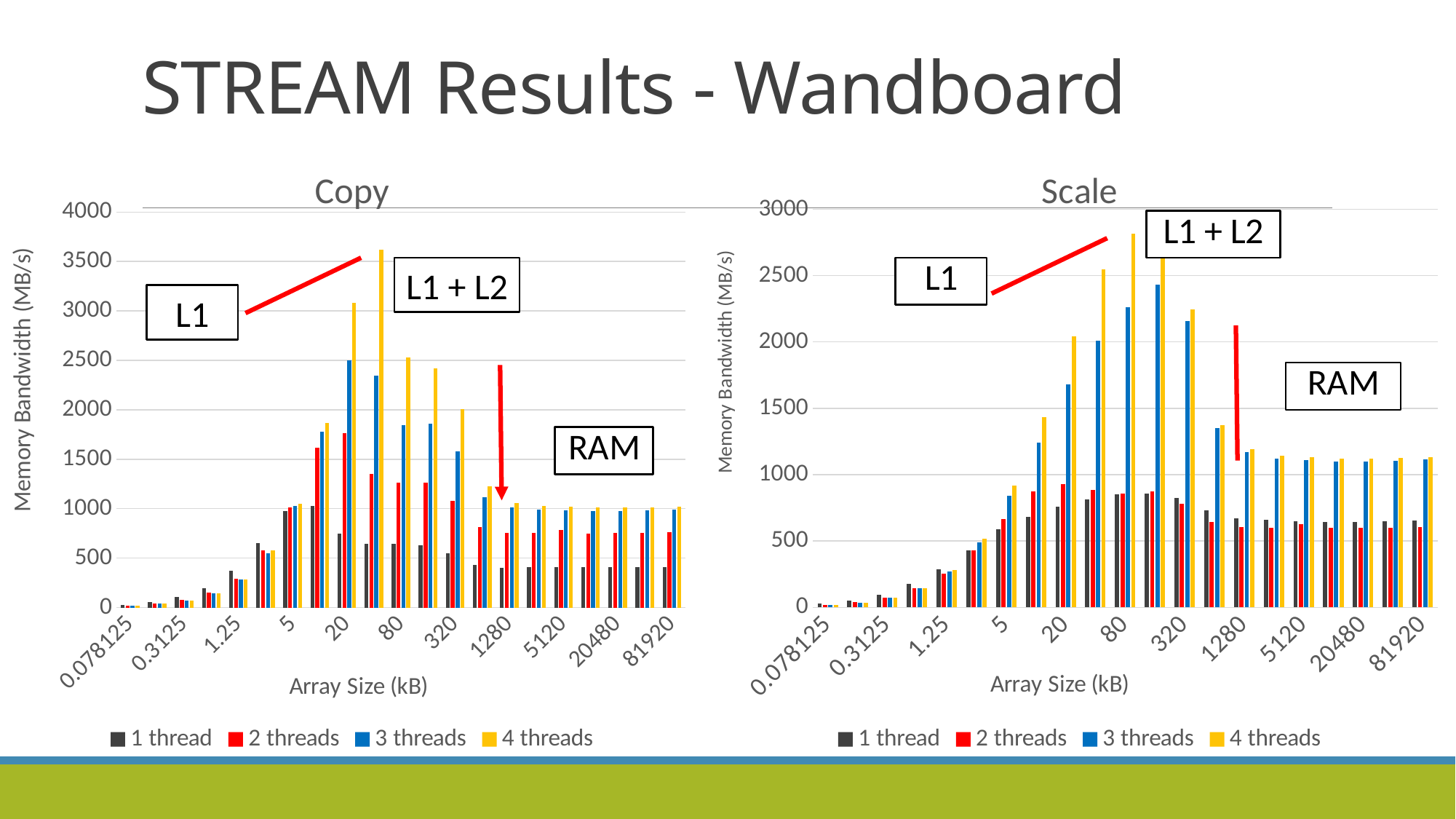
What is the highest tick value on the y-axis of the Copy chart? 4000 What is the y-axis title of the Scale chart? Memory Bandwidth (MB/s) In the Copy chart, is the highest 4 threads value greater or less than 3500? greater In the Scale chart, which series reaches the highest memory bandwidth overall? 4 threads In the Copy chart, at 81920 kB, which is larger: the 4 threads value or the 1 thread value? 4 threads How many series does the legend of the Scale chart list? 4 In the Copy chart, do the 4 threads values rise or fall as array size increases from 0.078125 kB to 20 kB? rise In the Copy chart, which series reaches the highest memory bandwidth overall? 4 threads What kind of chart is the Copy chart? bar chart In the Scale chart, is the 3 threads value at 81920 kB greater or less than 1000? greater In the Scale chart, is the highest 4 threads value greater or less than 2500? greater